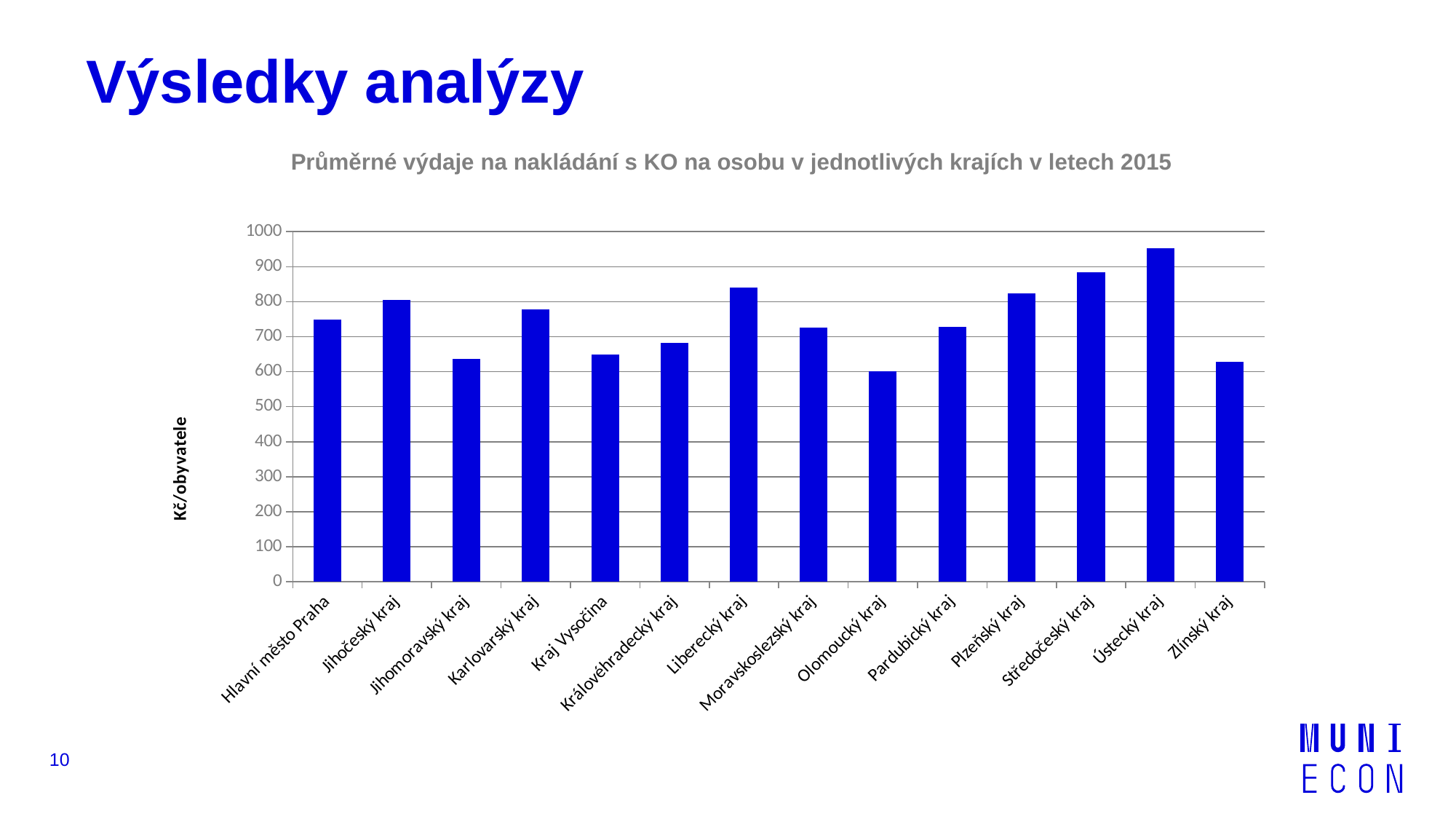
What kind of chart is shown on the slide? bar chart Which has a larger value, Karlovarský kraj or Kraj Vysočina? Karlovarský kraj Is the value for Hlavní město Praha greater or less than 800? less How many regions (kraje) are shown on the x axis of the chart? 14 Which region has the highest average expenditure per person in the chart? Ústecký kraj Is the value for Středočeský kraj greater or less than 800? greater Which has a larger value, Středočeský kraj or Plzeňský kraj? Středočeský kraj Which region has the lowest average expenditure per person in the chart? Olomoucký kraj Is the value for Královéhradecký kraj greater or less than 700? less What is the label of the vertical axis of the chart? Kč/obyvatele